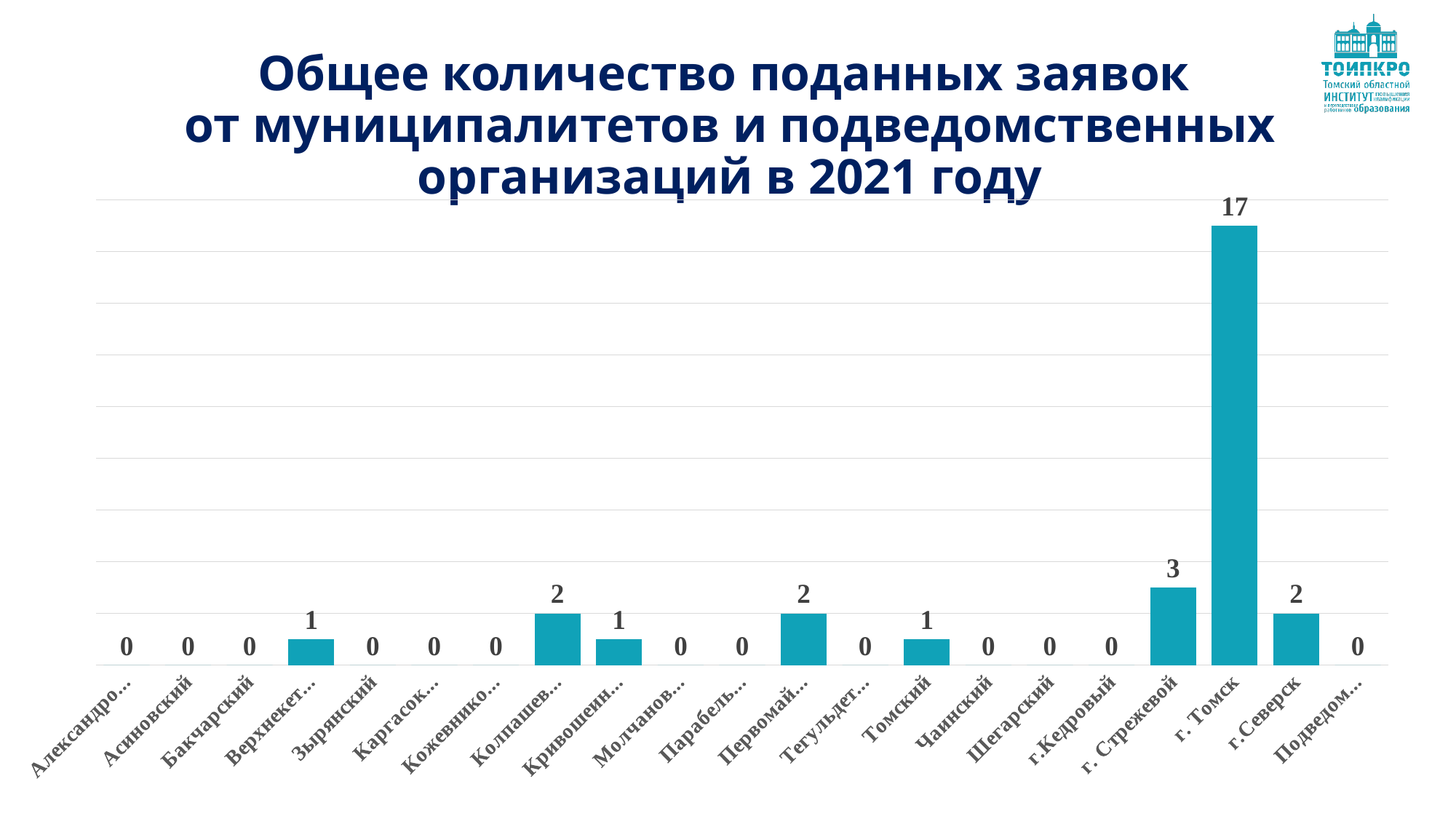
What is the difference between the values for г. Томск and г. Стрежевой? 14 How many categories are shown on the x axis? 21 What is the value for Томский? 1 What is the value for г. Томск? 17 Which is larger, the value for г. Северск or the value for Томский? г. Северск What type of chart is shown on the slide? bar chart Which category has the highest value? г. Томск What is the value for г. Стрежевой? 3 What is the value for г. Северск? 2 What is the value for Асиновский? 0 What is the difference between the values for г. Стрежевой and г. Северск? 1 What is the title of the chart? Общее количество поданных заявок от муниципалитетов и подведомственных организаций в 2021 году